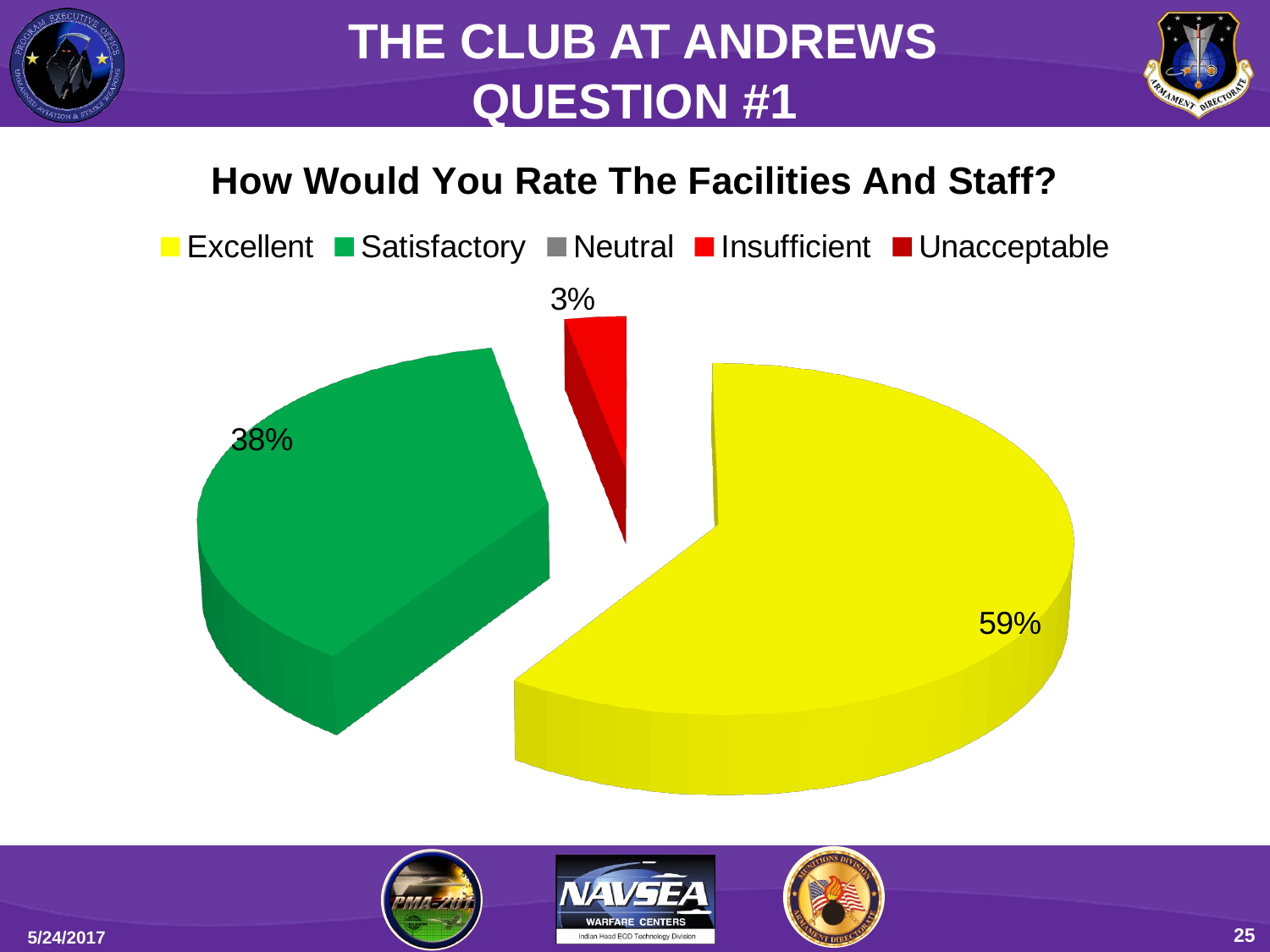
What percentage of respondents rated the facilities and staff as Satisfactory? 38% Which rating category has the largest share of the pie? Excellent How many categories does the legend list? 5 What colour represents the Excellent category in the legend? Yellow What percentage of respondents rated the facilities and staff as Insufficient? 3% What question does the chart title ask? How Would You Rate The Facilities And Staff? Which is larger, the Satisfactory share or the Insufficient share? Satisfactory What kind of chart is shown on the slide? Pie chart What percentage of respondents rated the facilities and staff as Excellent? 59% How many slices are visible on the pie chart? 3 How many percentage points larger is the Excellent share than the Satisfactory share? 21 percentage points Which of the slices shown on the pie is the smallest? Insufficient